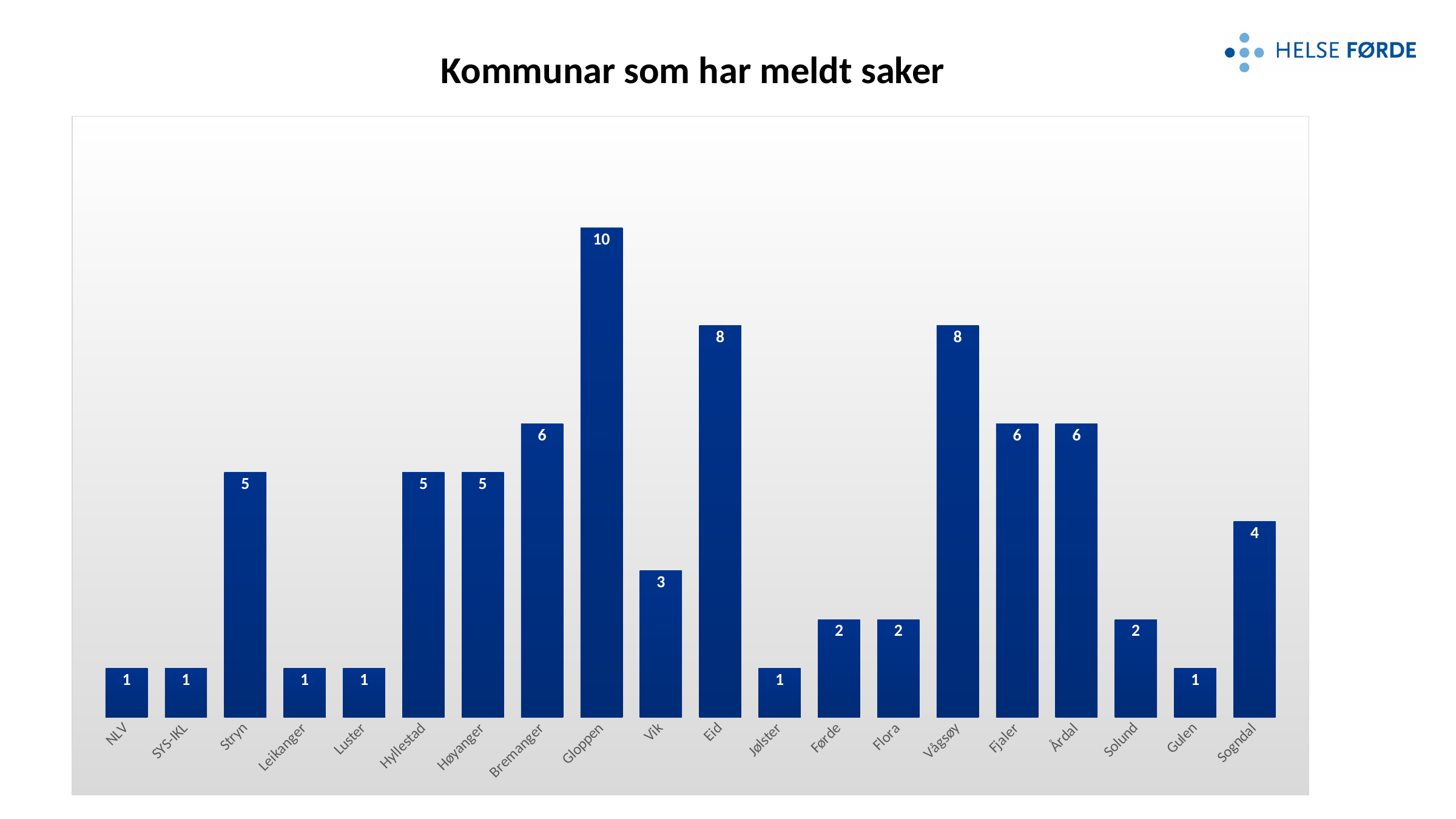
What is the difference between the values for Vågsøy and Vik? 5 What kind of chart is shown on the slide? Bar chart What is the value for Bremanger? 6 Which category has the highest value? Gloppen What is the value for Vik? 3 What is the value for Sogndal? 4 What is the title of the chart? Kommunar som har meldt saker How many categories are shown on the x axis? 20 What is the value for Gloppen? 10 Which is larger, the value for Stryn or the value for Fjaler? Fjaler What is the difference between the values for Gloppen and Eid? 2 Which is larger, the value for Sogndal or the value for Solund? Sogndal